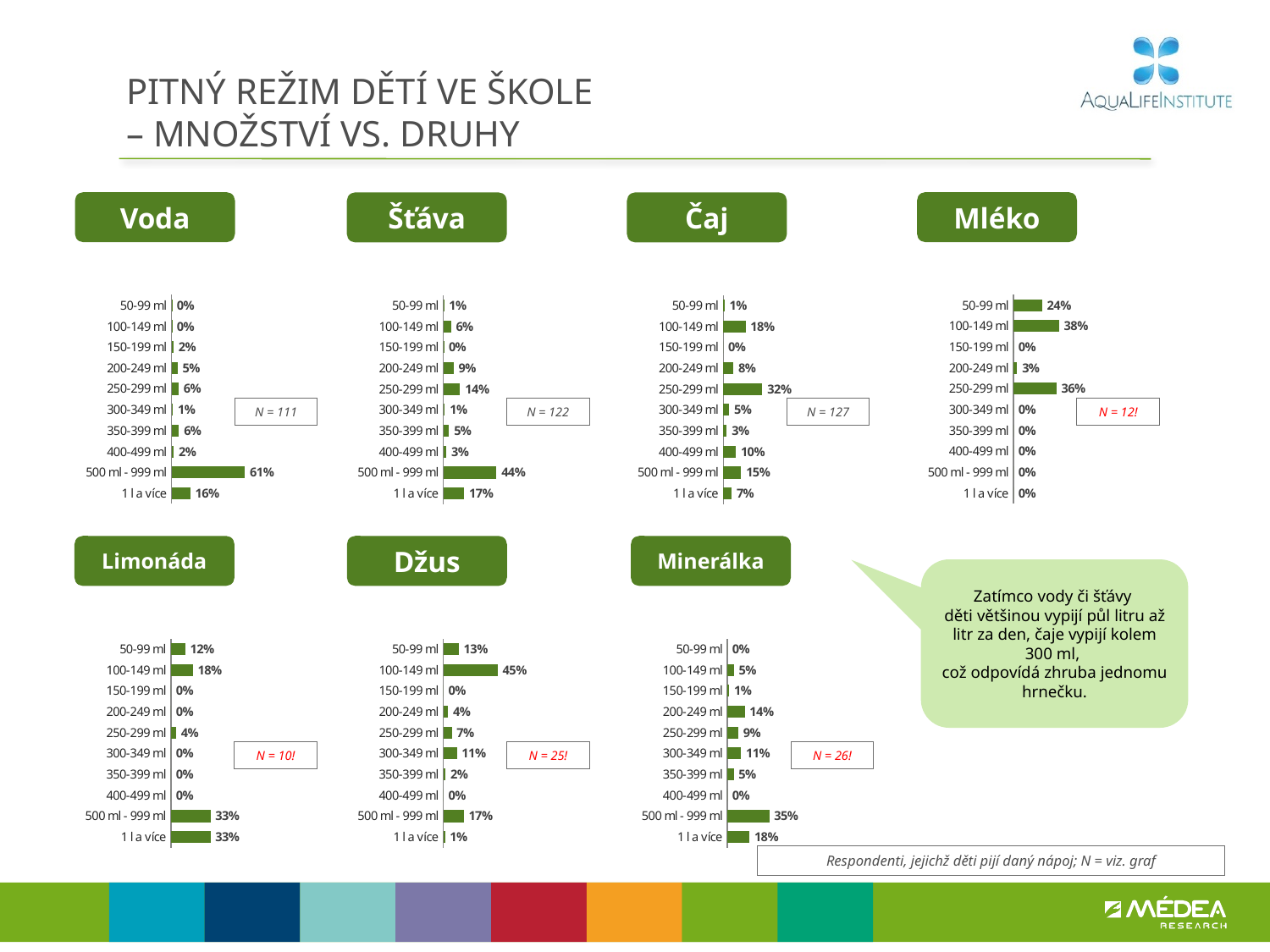
In the Limonáda chart, which is larger, the value for 50-99 ml or the value for 100-149 ml? 100-149 ml In the Mléko chart, what is the value for 100-149 ml? 38% In the Čaj chart, what is the difference between the values for 250-299 ml and 100-149 ml? 14% What kind of chart is the Čaj chart? bar chart In the Džus chart, which category has the highest value? 100-149 ml In the Šťáva chart, what is the value for 250-299 ml? 14% In the Čaj chart, which category has the highest value? 250-299 ml In the Šťáva chart, what is the value for 1 l a více? 17% What is the N value shown next to the Mléko chart? N = 12! In the Voda chart, what is the value for 500 ml - 999 ml? 61% How many categories does the Voda chart show? 10 In the Minerálka chart, what is the difference between the values for 500 ml - 999 ml and 1 l a více? 17%